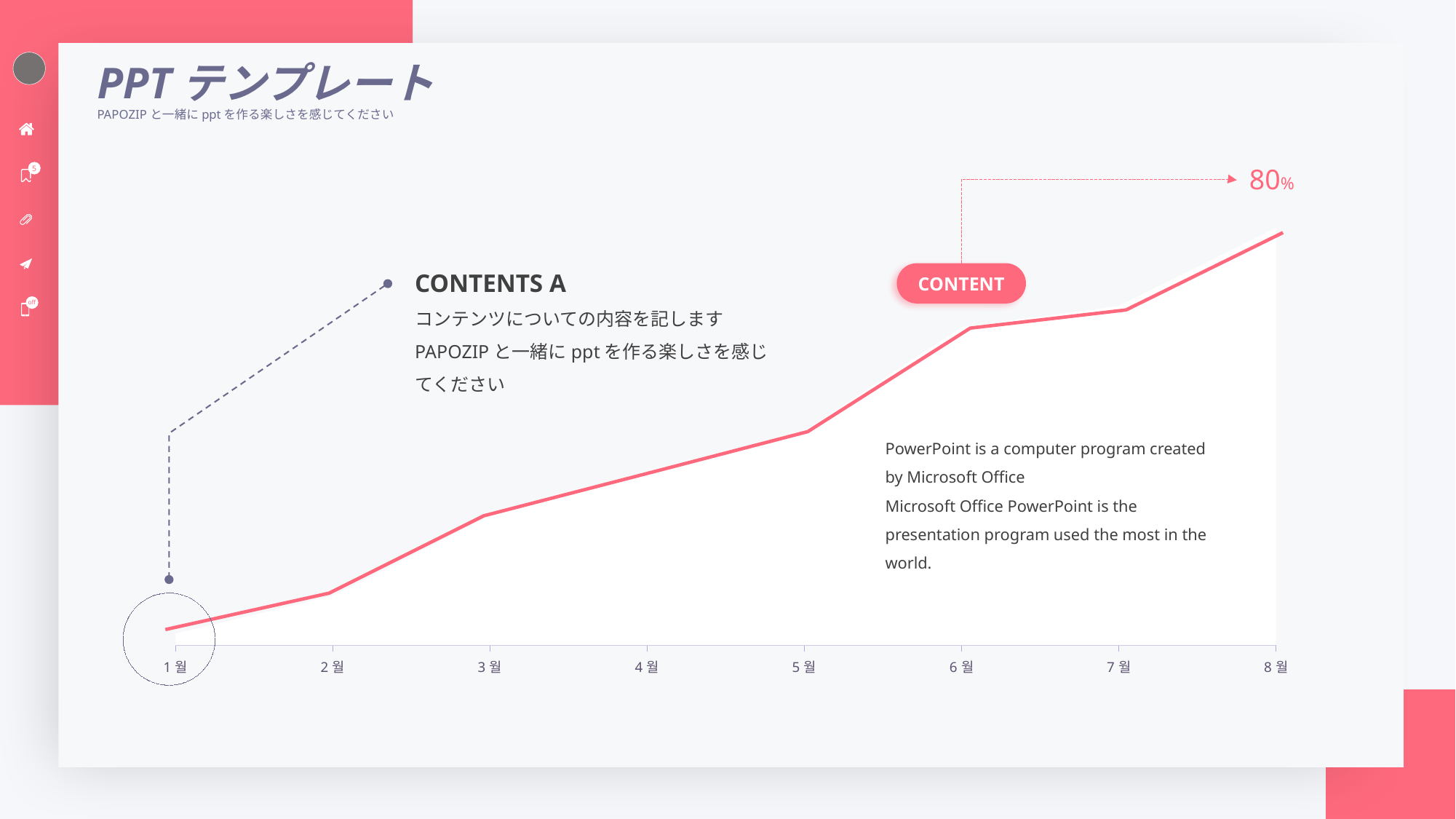
Which is larger, the value for 6月 or the value for 3月? 6月 How many categories are shown along the x axis of the chart? 8 What is the first category label on the x axis of the chart? 1月 What colour is the line plotted in the chart? pink Which is larger, the value for 2月 or the value for 5月? 5月 Which category has the lowest value in the chart? 1月 What kind of chart is shown on the slide? area chart Which category has the highest value in the chart? 8月 Which is larger, the value for 4月 or the value for 7月? 7月 Do the values rise or fall from 1月 to 8月? rise